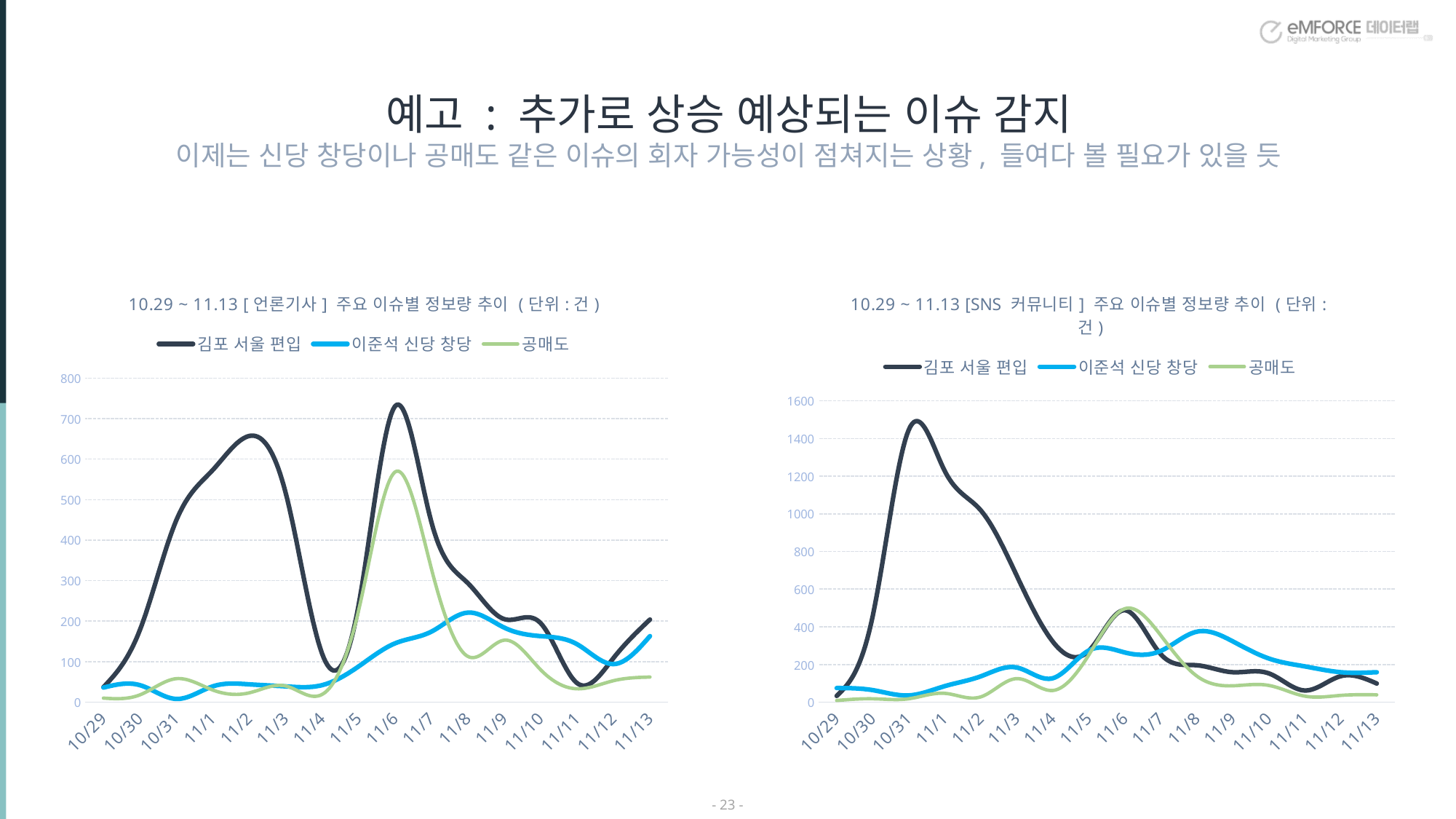
In the right chart ([SNS 커뮤니티]), which series has the larger value on 11/8: 이준석 신당 창당 or 김포 서울 편입? 이준석 신당 창당 In the left chart ([ 언론기사 ]), is the value of 공매도 on 11/6 greater or less than 500? greater What type of chart is the left chart titled '10.29 ~ 11.13 [ 언론기사 ] 주요 이슈별 정보량 추이'? Line chart In the left chart, which series is drawn in green according to the legend? 공매도 In the right chart ([SNS 커뮤니티]), on which date does the 김포 서울 편입 series reach its highest value? 10/31 In the left chart ([ 언론기사 ]), is the value of 김포 서울 편입 on 11/6 greater or less than 700? greater In the right chart ([SNS 커뮤니티]), does the 김포 서울 편입 series rise or fall from 10/31 to 11/11? Fall In the right chart ([SNS 커뮤니티]), is the value of 김포 서울 편입 on 11/13 greater or less than 200? less How many dates are shown on the x axis of the left chart ([ 언론기사 ])? 16 In the left chart ([ 언론기사 ]), on which date does the 김포 서울 편입 series reach its highest value? 11/6 How many series does the legend of the right chart ([SNS 커뮤니티]) list? 3